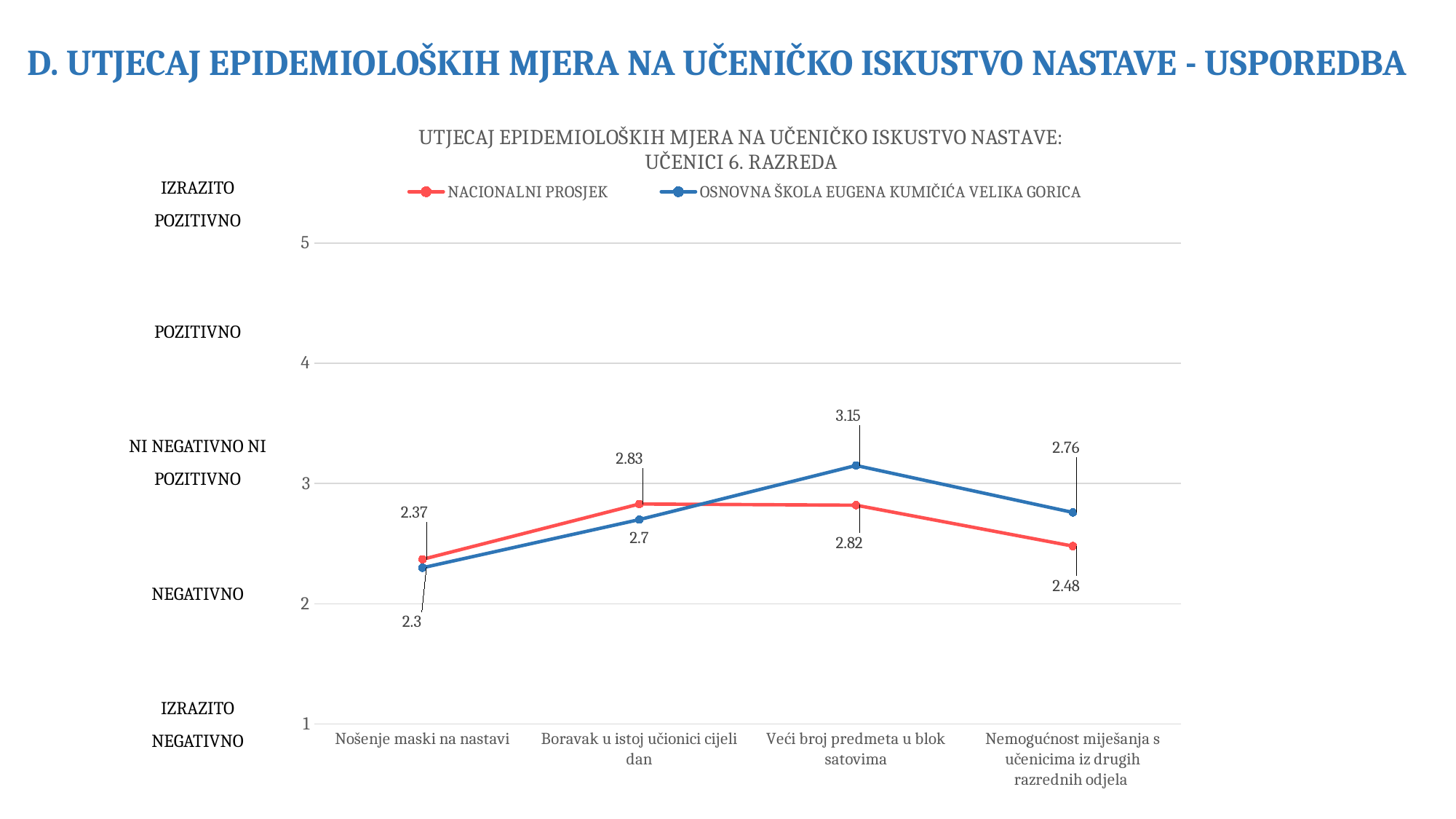
Which category has the lowest value for NACIONALNI PROSJEK? Nošenje maski na nastavi Is the value for OSNOVNA ŠKOLA EUGENA KUMIČIĆA VELIKA GORICA for "Veći broj predmeta u blok satovima" greater or less than 3? greater What is the difference between the two series for "Veći broj predmeta u blok satovima"? 0.33 What is the value for NACIONALNI PROSJEK for "Nošenje maski na nastavi"? 2.37 What kind of chart is shown on the slide? line chart How many series does the legend list? 2 What is the value for NACIONALNI PROSJEK for "Nemogućnost miješanja s učenicima iz drugih razrednih odjela"? 2.48 How many categories are shown on the x axis? 4 For "Nemogućnost miješanja s učenicima iz drugih razrednih odjela", which series has the larger value? OSNOVNA ŠKOLA EUGENA KUMIČIĆA VELIKA GORICA What is the value for OSNOVNA ŠKOLA EUGENA KUMIČIĆA VELIKA GORICA for "Nošenje maski na nastavi"? 2.3 What is the value for OSNOVNA ŠKOLA EUGENA KUMIČIĆA VELIKA GORICA for "Veći broj predmeta u blok satovima"? 3.15 Which category has the highest value for OSNOVNA ŠKOLA EUGENA KUMIČIĆA VELIKA GORICA? Veći broj predmeta u blok satovima